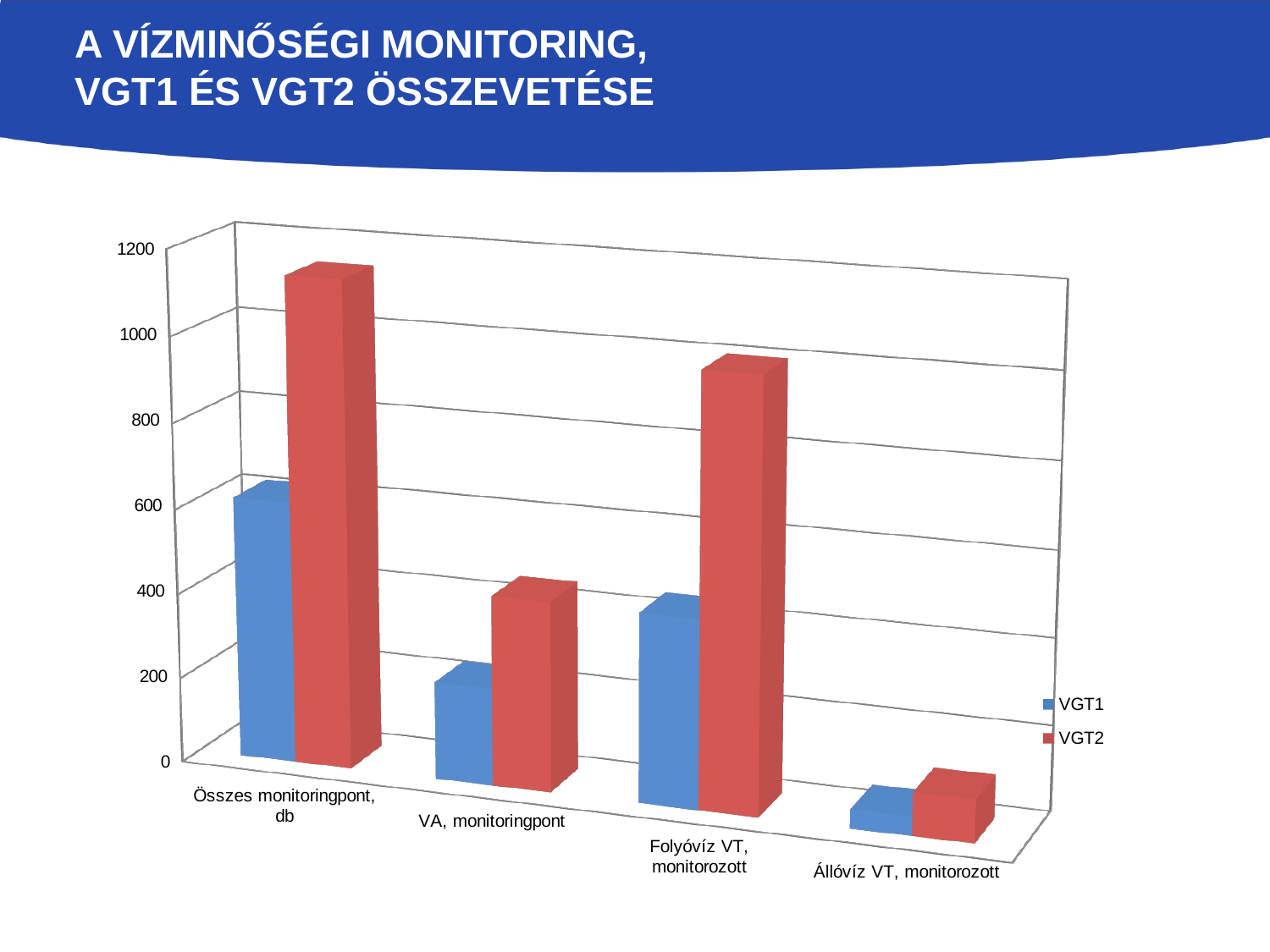
What kind of chart is shown on the slide? bar chart Which category has the highest VGT2 value? Összes monitoringpont, db How many categories are shown on the x axis? 4 Is the VGT1 value for Állóvíz VT, monitorozott greater or less than 200? less Is the VGT2 value for Folyóvíz VT, monitorozott greater or less than 800? greater Which colour represents the VGT2 series in the legend? red Which category has the lowest VGT1 value? Állóvíz VT, monitorozott Is the VGT2 value for Összes monitoringpont, db greater or less than 1000? greater For Folyóvíz VT, monitorozott, which series has the larger value, VGT1 or VGT2? VGT2 How many series does the legend list? 2